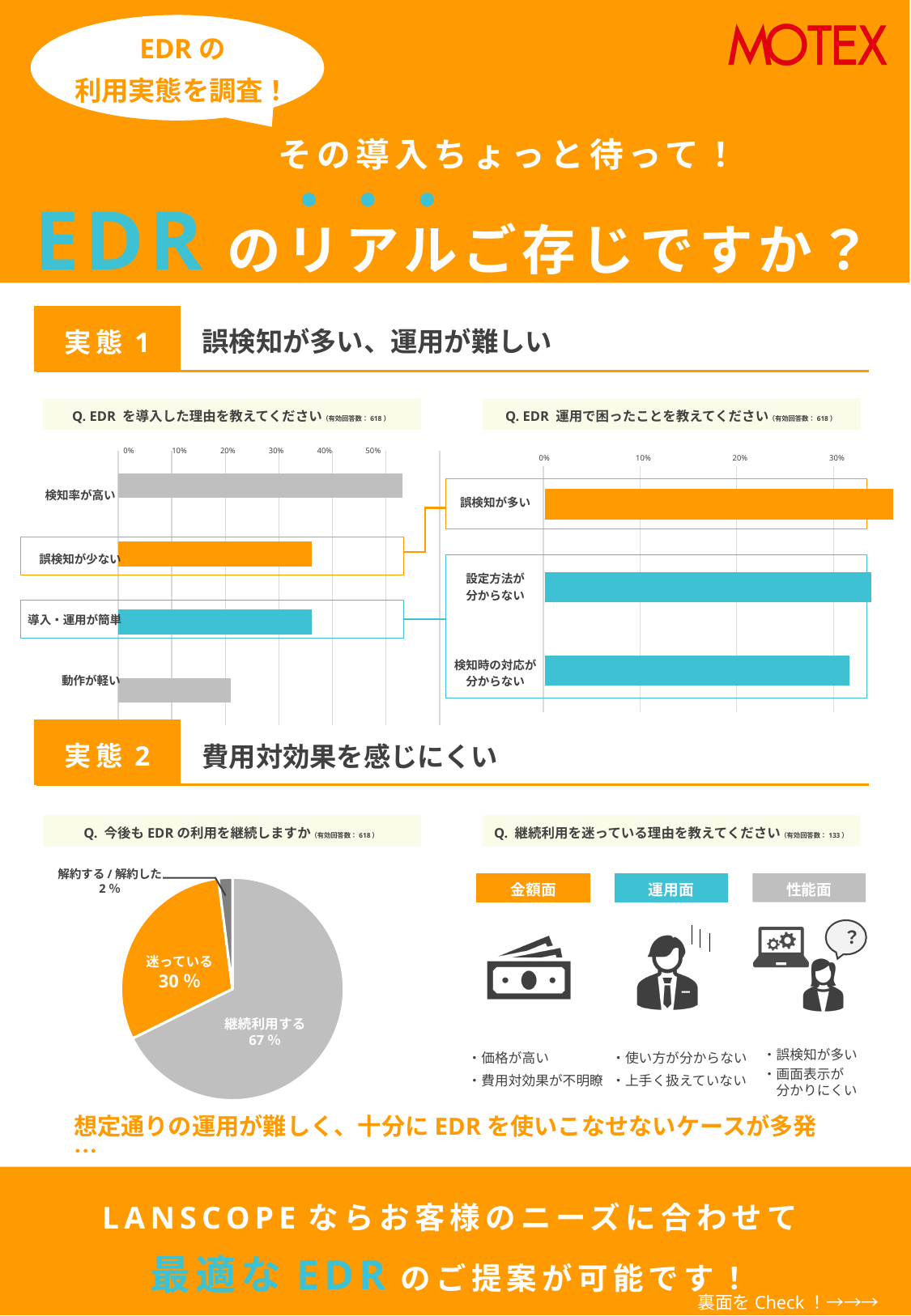
In the pie chart 「Q. 今後も EDR の利用を継続しますか」, which answer has the largest share? 継続利用する In the pie chart 「Q. 今後も EDR の利用を継続しますか」, what share of respondents answered 解約する / 解約した? 2% In the pie chart 「Q. 今後も EDR の利用を継続しますか」, what share of respondents answered 継続利用する? 67% In the pie chart 「Q. 今後も EDR の利用を継続しますか」, what share of respondents answered 迷っている? 30% In the chart 「Q. EDR を導入した理由を教えてください」, which reason has the highest value? 検知率が高い In the chart 「Q. EDR 運用で困ったことを教えてください」, which answer has the highest value? 誤検知が多い In the chart 「Q. EDR を導入した理由を教えてください」, which reason has the lowest value? 動作が軽い In the pie chart 「Q. 今後も EDR の利用を継続しますか」, what is the difference in percentage points between 継続利用する and 迷っている? 37 percentage points In the chart 「Q. EDR を導入した理由を教えてください」, is the value for 検知率が高い greater or less than 50%? greater In the chart 「Q. EDR 運用で困ったことを教えてください」, is the value for 誤検知が多い greater or less than 30%? greater What kind of chart is used for 「Q. EDR を導入した理由を教えてください」? Bar chart How many slices does the pie chart 「Q. 今後も EDR の利用を継続しますか」 have? 3